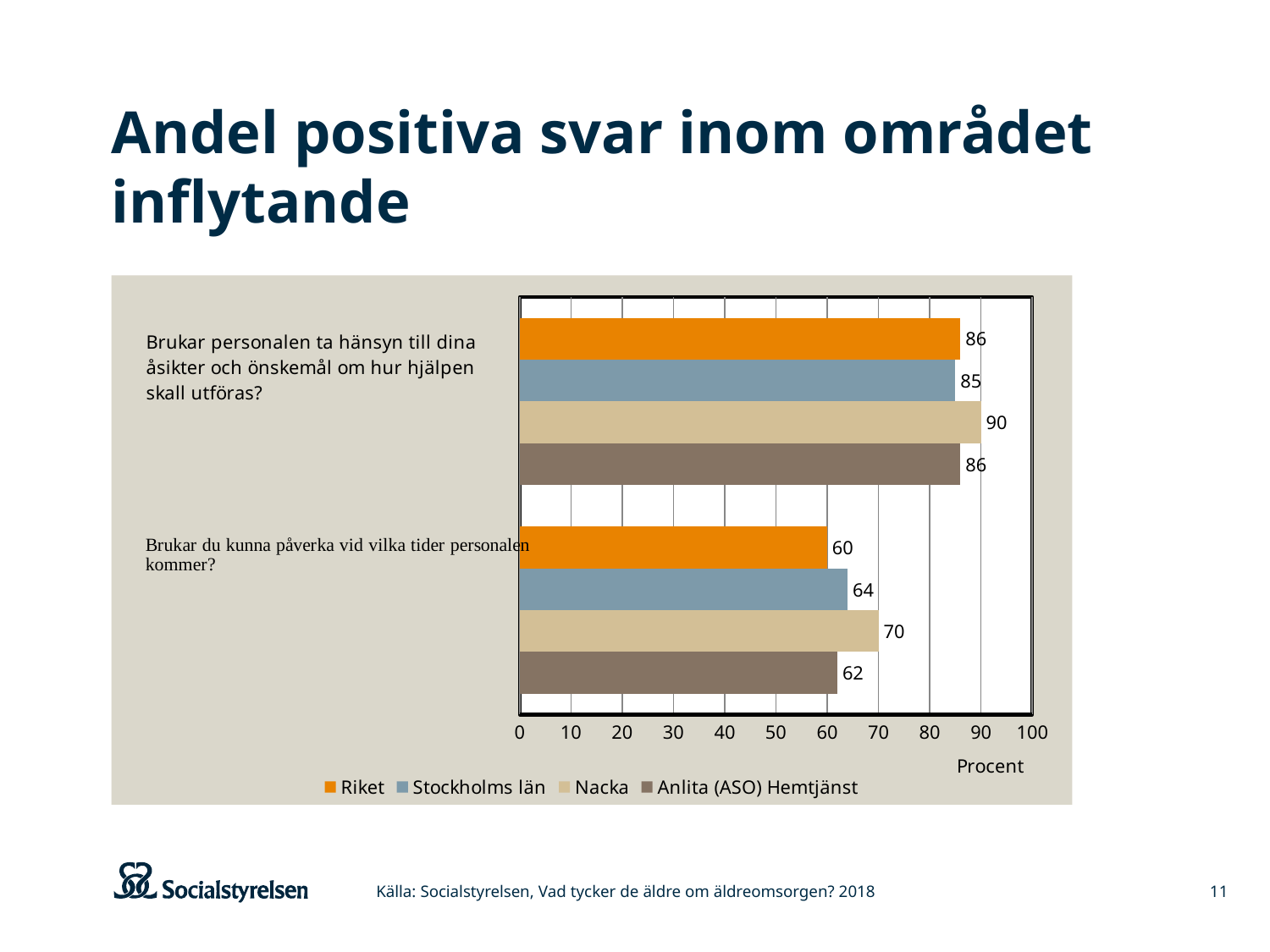
Which series has the highest value on the question "Brukar du kunna påverka vid vilka tider personalen kommer?"? Nacka What is the difference between the Nacka value and the Riket value on the question "Brukar du kunna påverka vid vilka tider personalen kommer?"? 10 What is the value for Riket on the question "Brukar du kunna påverka vid vilka tider personalen kommer?"? 60 How many series does the legend list? 4 What is the value for Stockholms län on the question "Brukar du kunna påverka vid vilka tider personalen kommer?"? 64 Which series has the lowest value on the question "Brukar du kunna påverka vid vilka tider personalen kommer?"? Riket Which is larger on the question "Brukar personalen ta hänsyn till dina åsikter och önskemål om hur hjälpen skall utföras?": the value for Nacka or the value for Stockholms län? Nacka How many questions (categories) are shown on the chart? 2 What kind of chart is shown on the slide? bar chart What is the value for Anlita (ASO) Hemtjänst on the question "Brukar personalen ta hänsyn till dina åsikter och önskemål om hur hjälpen skall utföras?"? 86 What unit is shown on the horizontal axis of the chart? Procent What is the value for Nacka on the question "Brukar personalen ta hänsyn till dina åsikter och önskemål om hur hjälpen skall utföras?"? 90